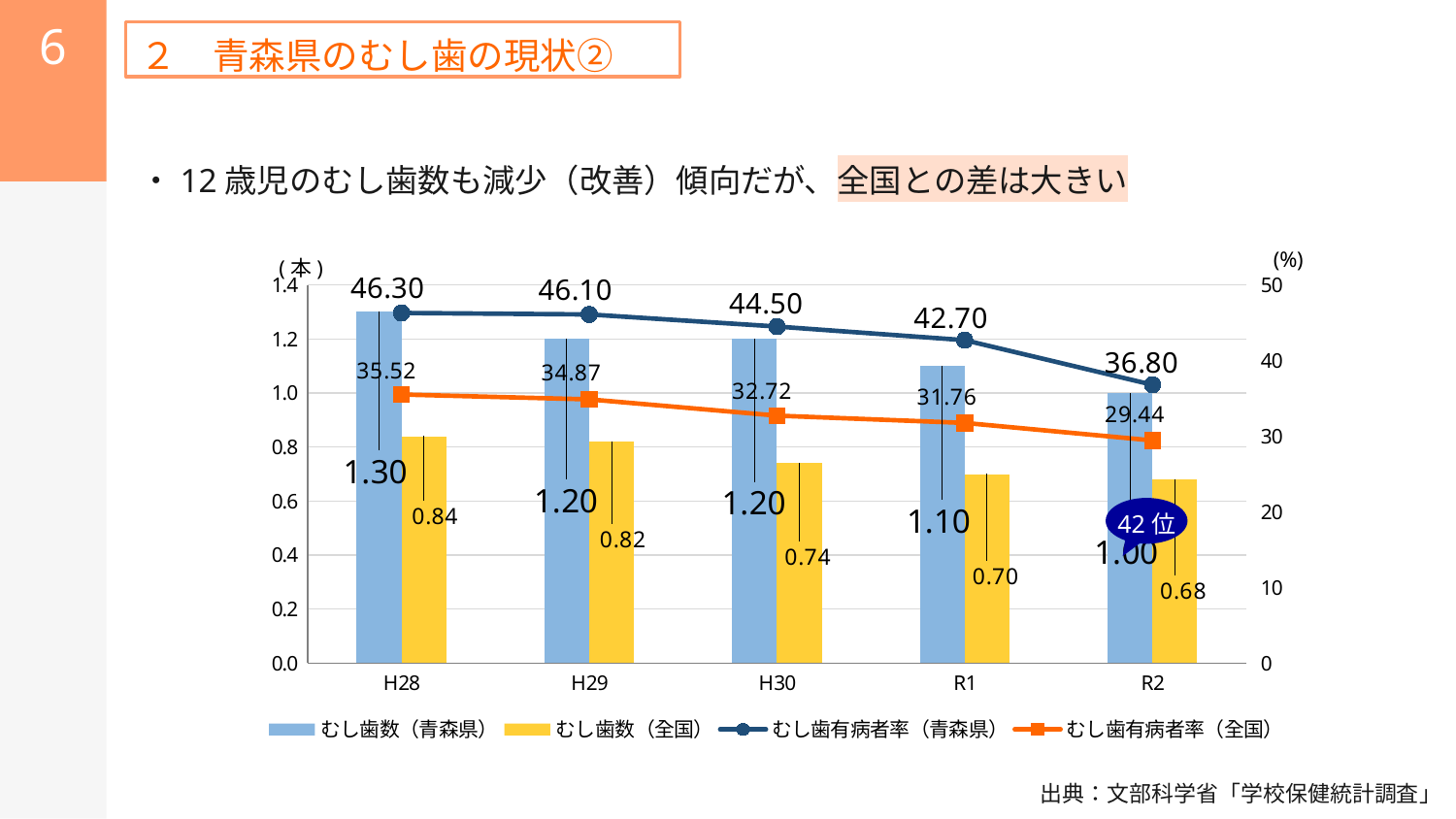
What kind of chart is this? Combined bar and line chart How many years are shown on the x axis? 5 What is the value of むし歯有病者率（青森県） for H30? 44.50 What is the value of むし歯有病者率（全国） for R1? 31.76 What is the difference between むし歯有病者率（青森県） and むし歯有病者率（全国） in H28? 10.78 In which year is むし歯数（全国） highest? H28 Which is larger in R2: むし歯数（青森県） or むし歯数（全国）? むし歯数（青森県） What is the value of むし歯数（全国） for R2? 0.68 Does むし歯有病者率（全国） rise or fall from H28 to R2? fall What is the value of むし歯数（青森県） for H28? 1.30 In which year is むし歯有病者率（青森県） lowest? R2 How many series does the legend list? 4